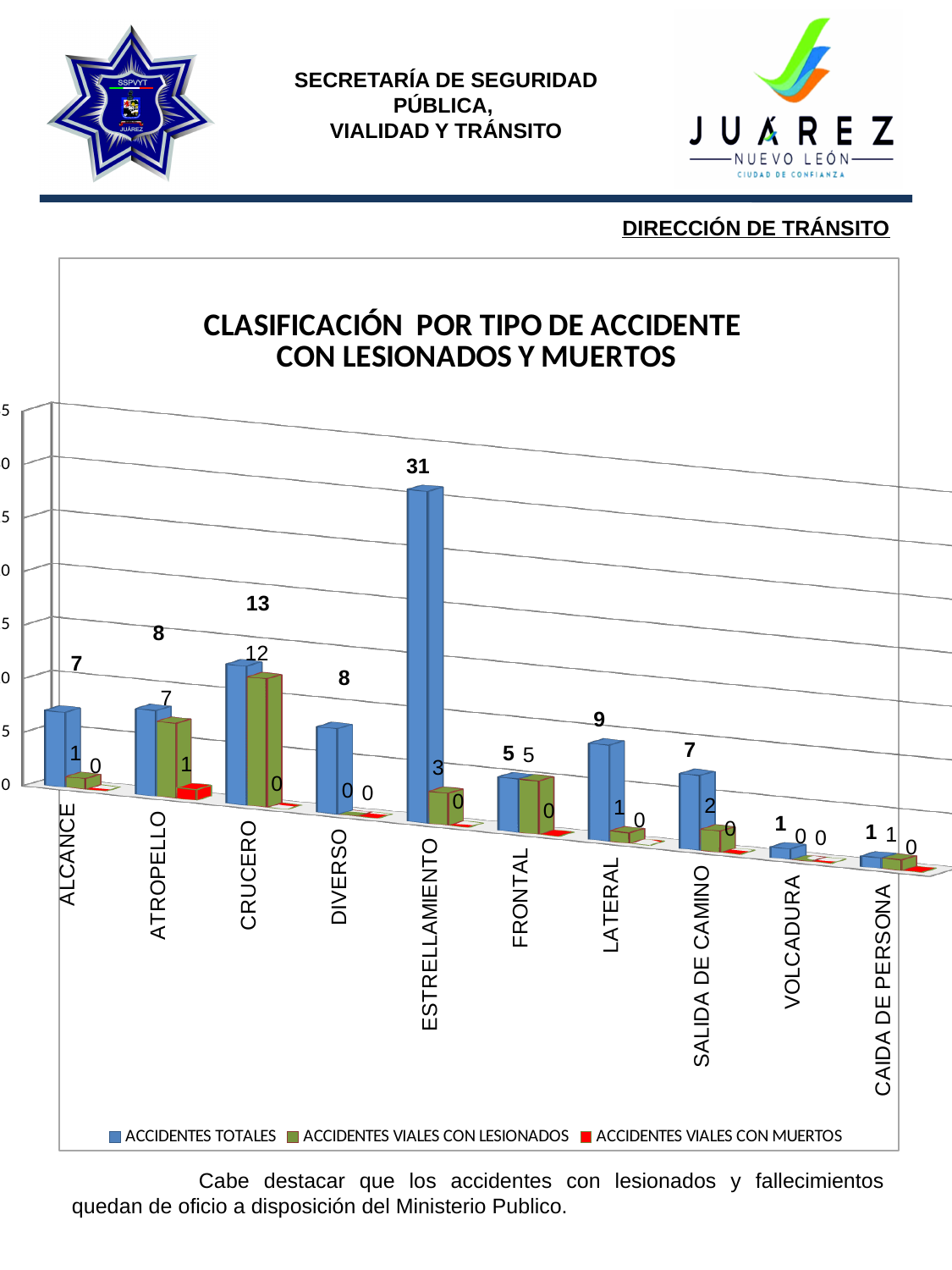
What is the value of ACCIDENTES VIALES CON MUERTOS for ATROPELLO? 1 Which accident type has the highest value for ACCIDENTES VIALES CON LESIONADOS? CRUCERO What is the value of ACCIDENTES VIALES CON LESIONADOS for CRUCERO? 12 How many series does the legend list? 3 Which accident type has the highest value for ACCIDENTES TOTALES? ESTRELLAMIENTO Which has more ACCIDENTES TOTALES, ATROPELLO or LATERAL? LATERAL What is the difference between ACCIDENTES TOTALES for ESTRELLAMIENTO and for CRUCERO? 18 What is the value of ACCIDENTES VIALES CON LESIONADOS for FRONTAL? 5 How many accident types are shown on the x axis? 10 Which accident type has the highest value for ACCIDENTES VIALES CON MUERTOS? ATROPELLO What kind of chart is shown on the slide? Bar chart What is the value of ACCIDENTES TOTALES for ESTRELLAMIENTO? 31